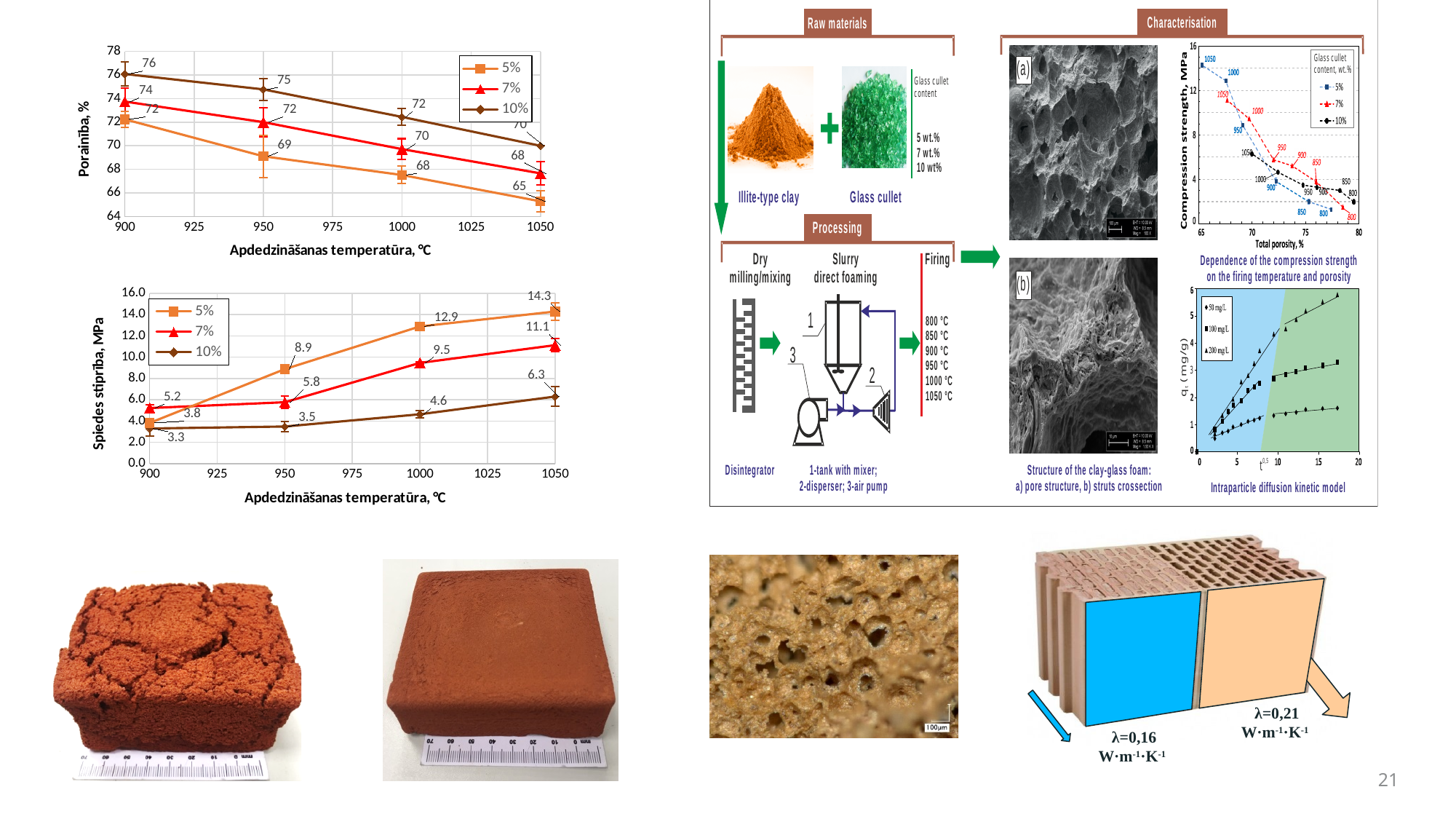
In the top-left chart (Porainība, %), what is the value for the 10% series at 900 °C? 76 In the bottom-left chart (Spiedes stiprība, MPa), which series has the lowest value at 1050 °C? 10% In the top-left chart (Porainība, %), do the values rise or fall as temperature increases? fall What type of chart is the bottom-left chart (Spiedes stiprība, MPa)? line chart In the top-left chart (Porainība, %), what is the value for the 5% series at 1050 °C? 65 In the bottom-left chart (Spiedes stiprība, MPa), what is the value for the 10% series at 900 °C? 3.3 In the bottom-left chart (Spiedes stiprība, MPa), which is larger at 900 °C: the 5% series or the 7% series? 7% In the top-left chart (Porainība, %), which series has the highest value at 1000 °C? 10% In the top-left chart (Porainība, %), how many series does the legend list? 3 In the top-left chart (Porainība, %), what is the difference between the 10% and 5% series at 950 °C? 6 In the bottom-left chart (Spiedes stiprība, MPa), what is the value for the 5% series at 1050 °C? 14.3 In the bottom-left chart (Spiedes stiprība, MPa), what is the difference between the 5% and 7% series at 1000 °C? 3.4